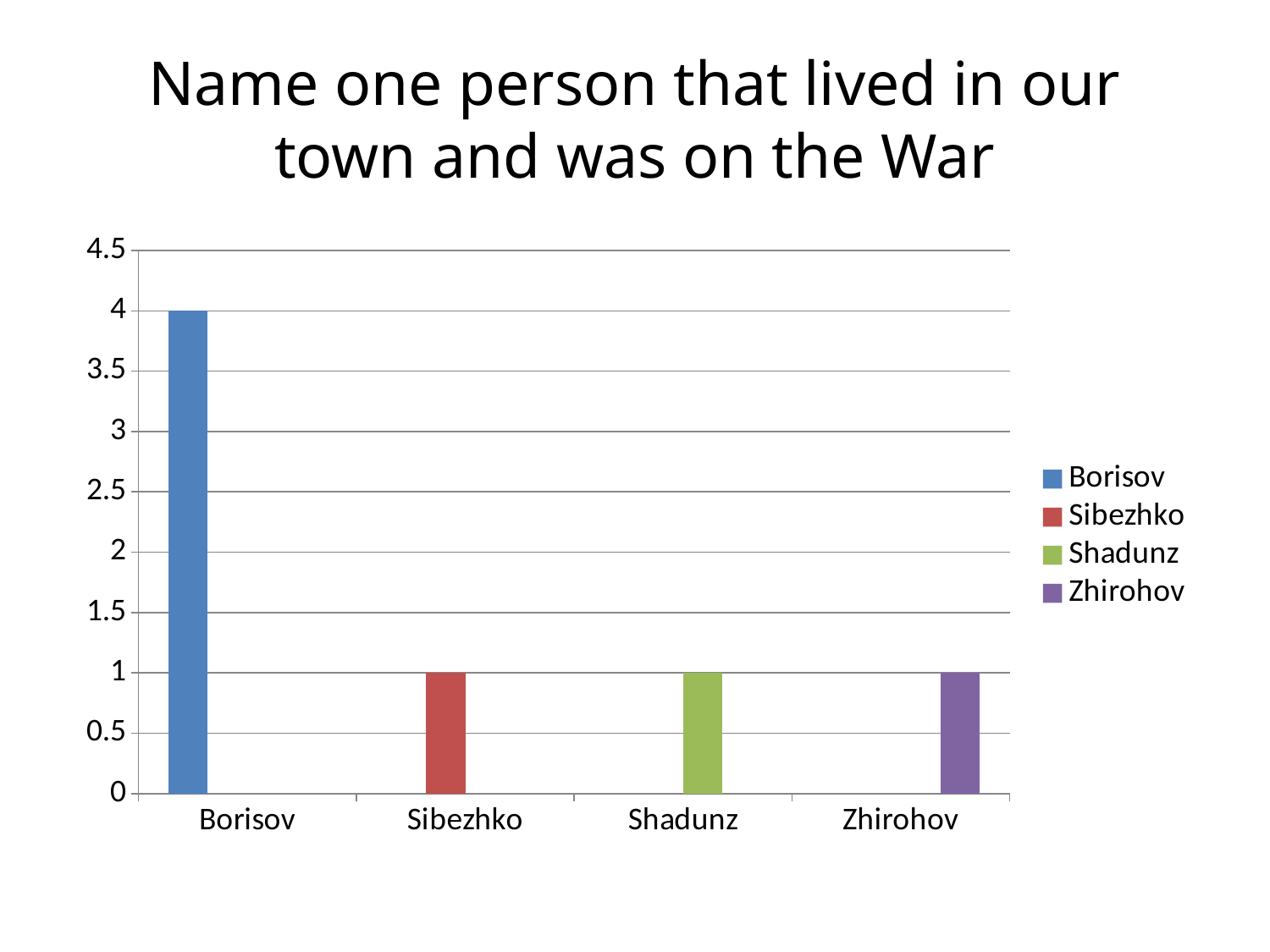
What is the title of the slide? Name one person that lived in our town and was on the War What is the value for Sibezhko? 1 How many entries does the legend list? 4 Is the value for Shadunz greater or less than 2? less What is the value for Borisov? 4 What is the value for Zhirohov? 1 Which is larger, the value for Borisov or the value for Shadunz? Borisov Which category has the highest value? Borisov What kind of chart is shown on the slide? bar chart Is the value for Borisov greater or less than 3? greater What is the difference between the values for Borisov and Sibezhko? 3 How many categories are shown on the x axis? 4